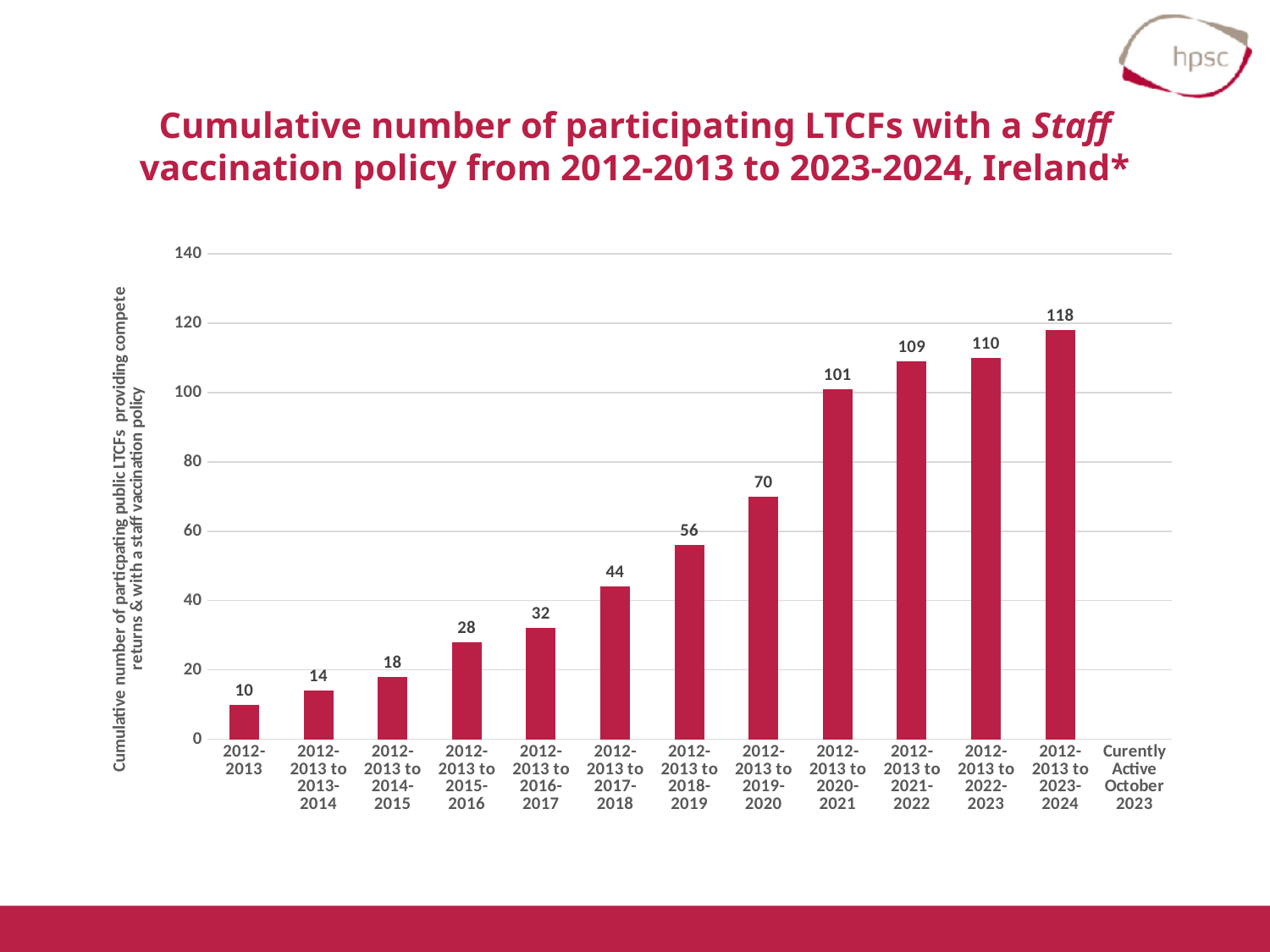
What value is shown for 2012-2013 to 2019-2020? 70 Is the value for 2012-2013 to 2021-2022 greater or less than 100? greater Do the values rise or fall from 2012-2013 to 2012-2013 to 2023-2024? rise Which is larger, the value for 2012-2013 to 2016-2017 or the value for 2012-2013 to 2017-2018? 2012-2013 to 2017-2018 What value is shown for 2012-2013 to 2023-2024? 118 What is the difference between the values for 2012-2013 to 2020-2021 and 2012-2013 to 2019-2020? 31 What kind of chart is shown on the slide? bar chart Which period has the highest cumulative number of participating LTCFs with a staff vaccination policy? 2012-2013 to 2023-2024 What is the cumulative number of participating LTCFs with a staff vaccination policy for 2012-2013? 10 What is the maximum value shown on the vertical axis? 140 Which period has the lowest value on the chart? 2012-2013 How many bars are plotted on the chart? 12